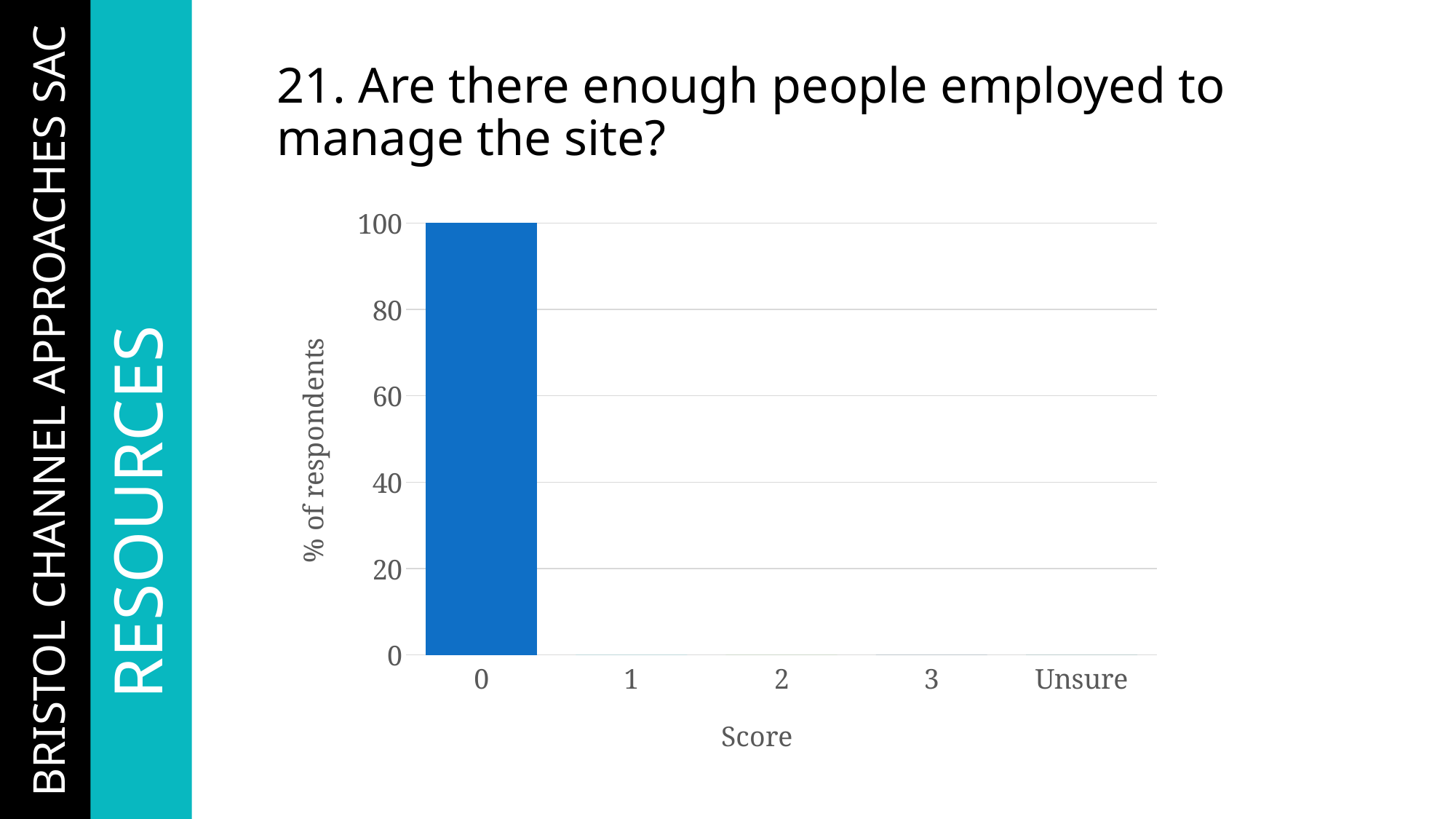
What is the label of the y axis? % of respondents Which is larger, the value for score 0 or the value for score 1? 0 Which score category has the highest % of respondents? 0 What is the % of respondents for Unsure? 0 What is the % of respondents for score 0? 100 Is the value for score 0 greater or less than 80? greater What is the difference between the value for score 0 and the value for Unsure? 100 What type of chart is shown on the slide? bar chart How many categories are shown on the x axis? 5 What is the label of the x axis? Score What is the highest value shown on the y axis? 100